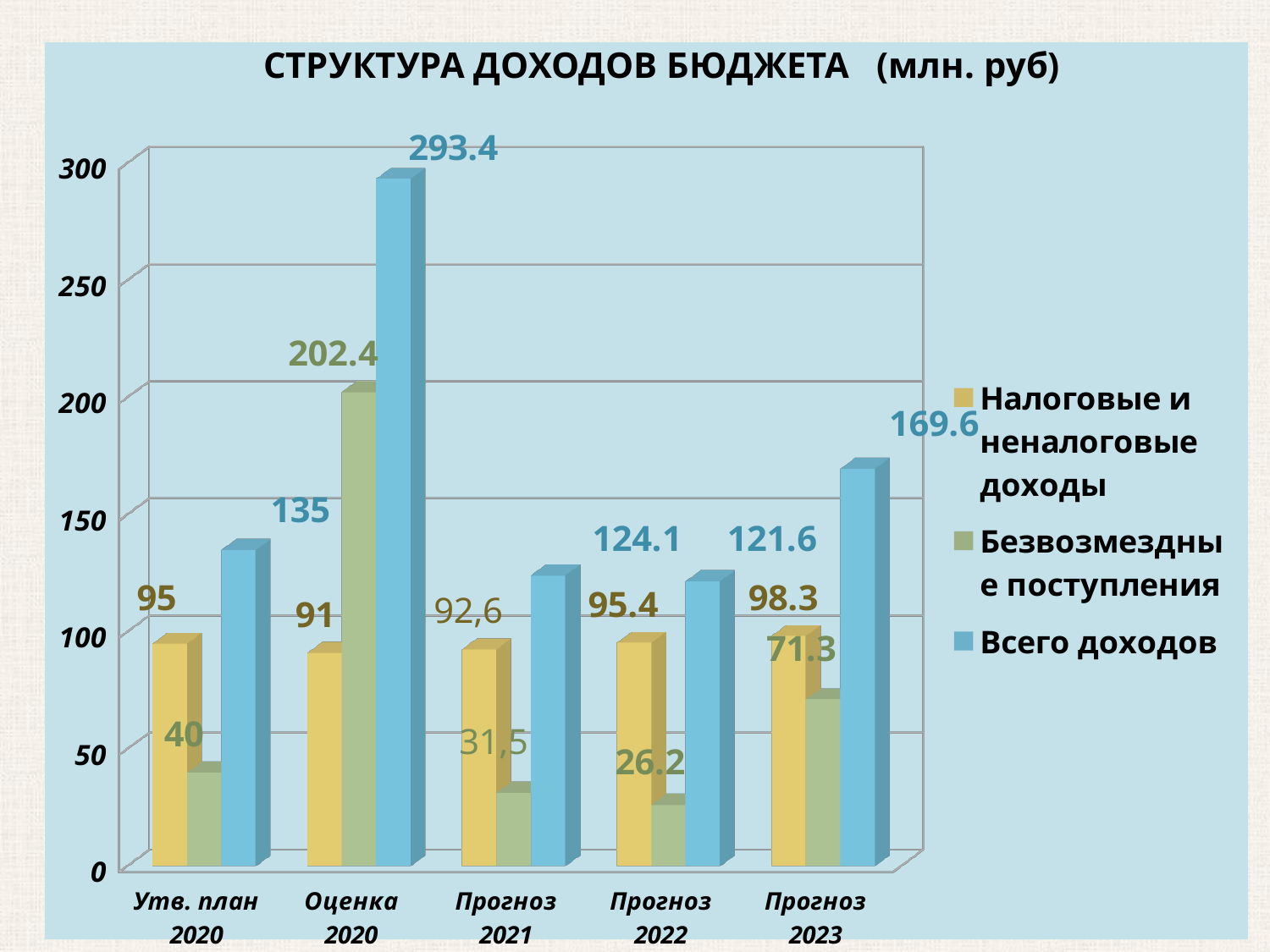
What is the difference between Всего доходов for Прогноз 2023 and Прогноз 2022? 48 What is the value of Безвозмездные поступления for Прогноз 2021? 31,5 What is the value of Всего доходов for Утв. план 2020? 135 Which is larger: Безвозмездные поступления for Оценка 2020 or for Прогноз 2023? Оценка 2020 What is the value of Налоговые и неналоговые доходы for Прогноз 2023? 98.3 Which category has the lowest value of Безвозмездные поступления? Прогноз 2022 What kind of chart is shown on the slide? Bar chart How many categories are shown on the x axis? 5 How many series does the legend list? 3 Which category has the highest value of Всего доходов? Оценка 2020 What is the title of the chart? СТРУКТУРА ДОХОДОВ БЮДЖЕТА (млн. руб) What is the value of Всего доходов for Оценка 2020? 293.4